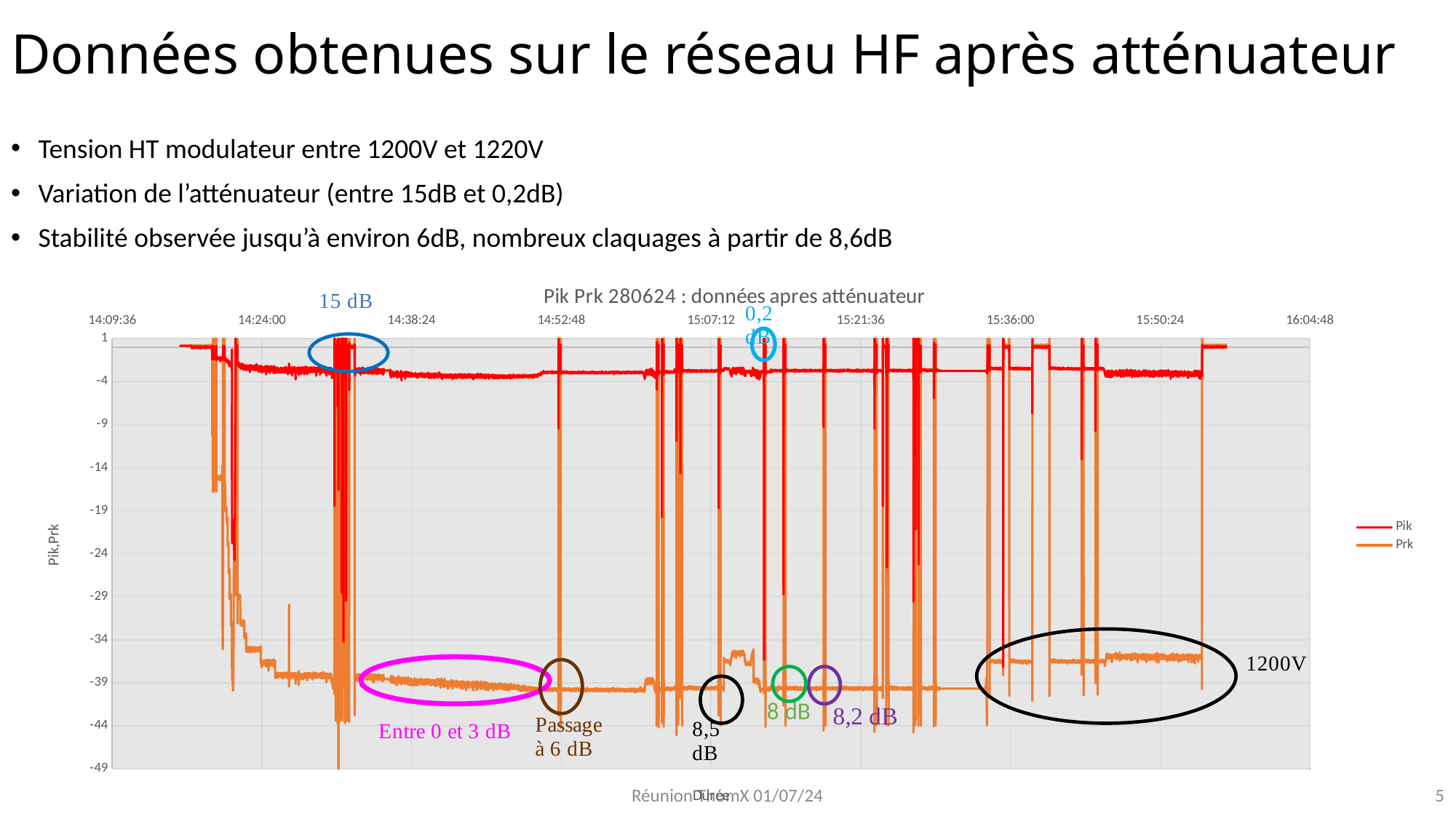
What kind of chart is shown on the slide? line chart How many time labels are shown on the x axis? 9 Is the Prk value at 15:50:24 greater or less than -44? greater Does the Prk series rise or fall between 14:24:00 and 14:38:24? fall Which series, Pik or Prk, reaches the lowest value on the chart? Prk What are the names of the two series in the legend? Pik and Prk What is the title of the chart? Pik Prk 280624 : données apres atténuateur Which series, Pik or Prk, has the higher values around 15:00:00? Pik What is the lowest value labelled on the y axis? -49 How many series does the legend list? 2